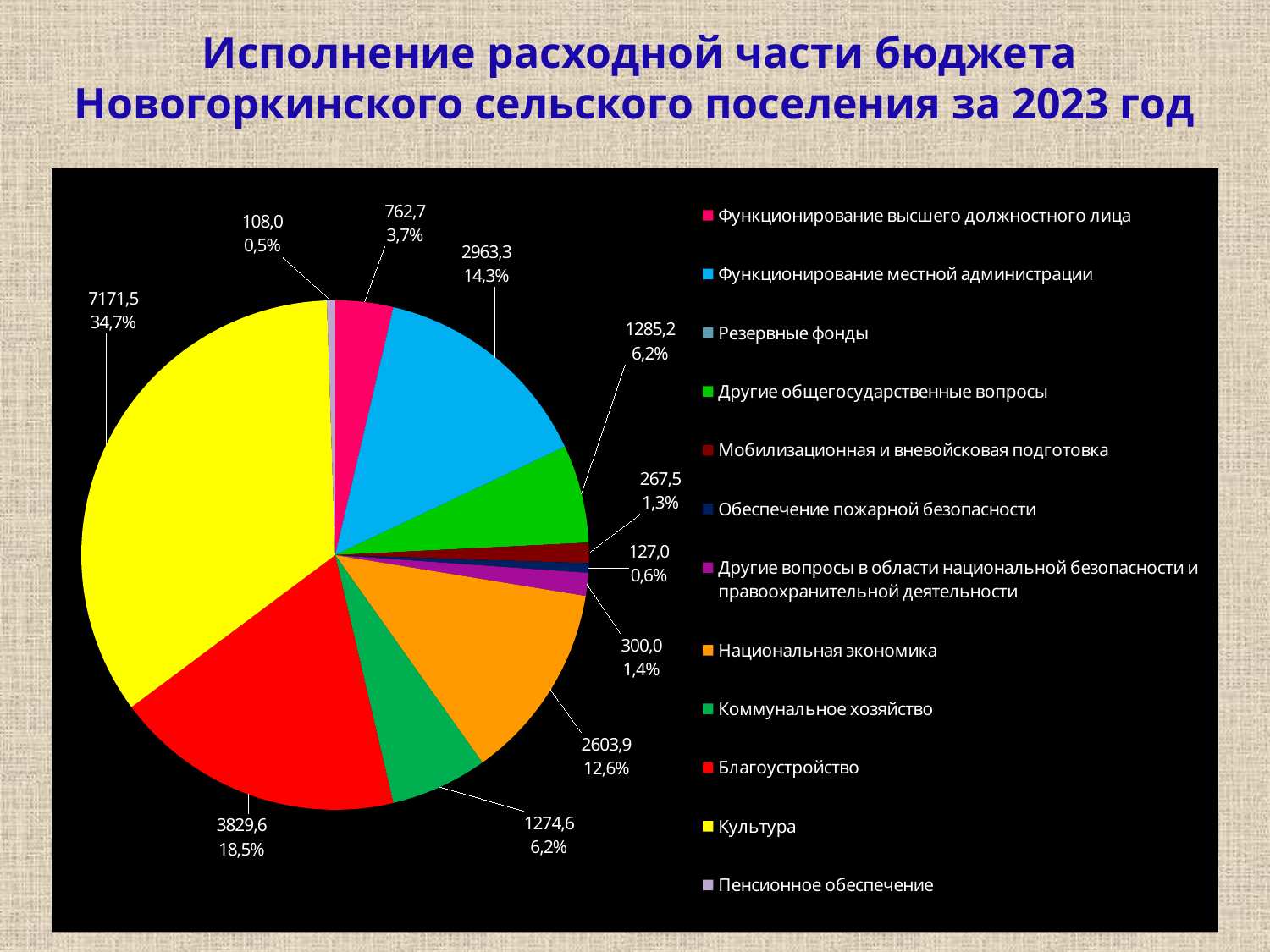
What share of the pie does Функционирование местной администрации take? 14,3% What is the difference between the values for Культура and Благоустройство? 3341,9 What value is shown for Культура? 7171,5 How many entries does the legend list? 12 Which is larger, Благоустройство or Национальная экономика? Благоустройство What share of the pie does Пенсионное обеспечение take? 0,5% What share of the pie does Культура take? 34,7% What value is shown for Обеспечение пожарной безопасности? 127,0 What value is shown for Благоустройство? 3829,6 Which category has the largest slice of the pie? Культура What value is shown for Национальная экономика? 2603,9 What kind of chart is shown on the slide? pie chart